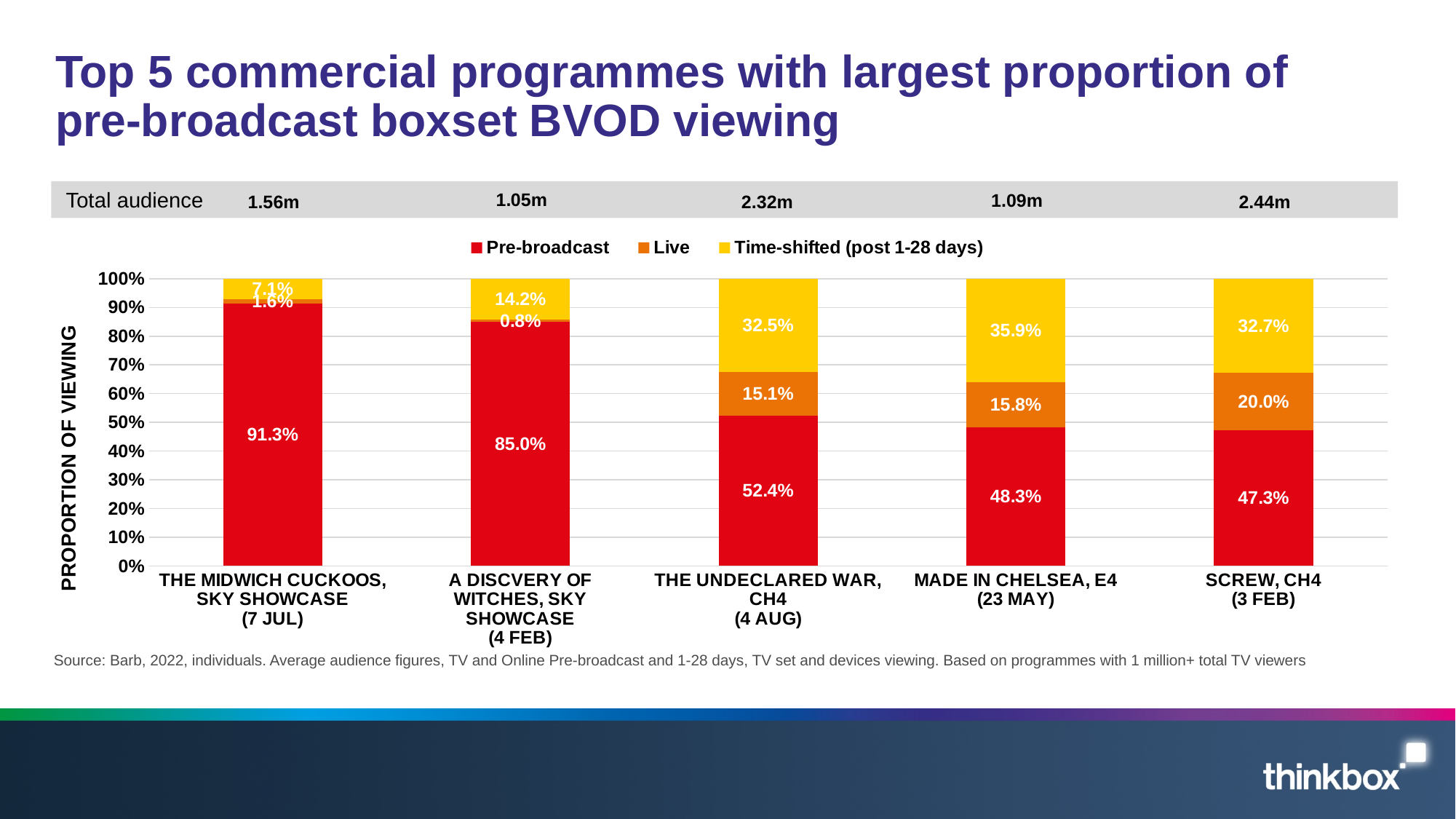
What is the Live share for Screw, CH4 (3 Feb)? 20.0% Which colour represents Time-shifted (post 1-28 days) in the legend? Yellow What is the Pre-broadcast share for The Undeclared War, CH4 (4 Aug)? 52.4% What kind of chart is shown on the slide? Stacked bar chart Which programme has the highest Pre-broadcast share? The Midwich Cuckoos, Sky Showcase (7 Jul) What is the difference in Pre-broadcast share between The Midwich Cuckoos and A Discvery of Witches? 6.3% What is the Time-shifted (post 1-28 days) share for Made in Chelsea, E4 (23 May)? 35.9% How many programmes are shown on the x axis? 5 How many series does the legend list? 3 Which programme has the lowest Pre-broadcast share? Screw, CH4 (3 Feb) Which has a larger Time-shifted share: The Undeclared War or Screw? Screw, CH4 (3 Feb) What is the Live share for A Discvery of Witches, Sky Showcase (4 Feb)? 0.8%